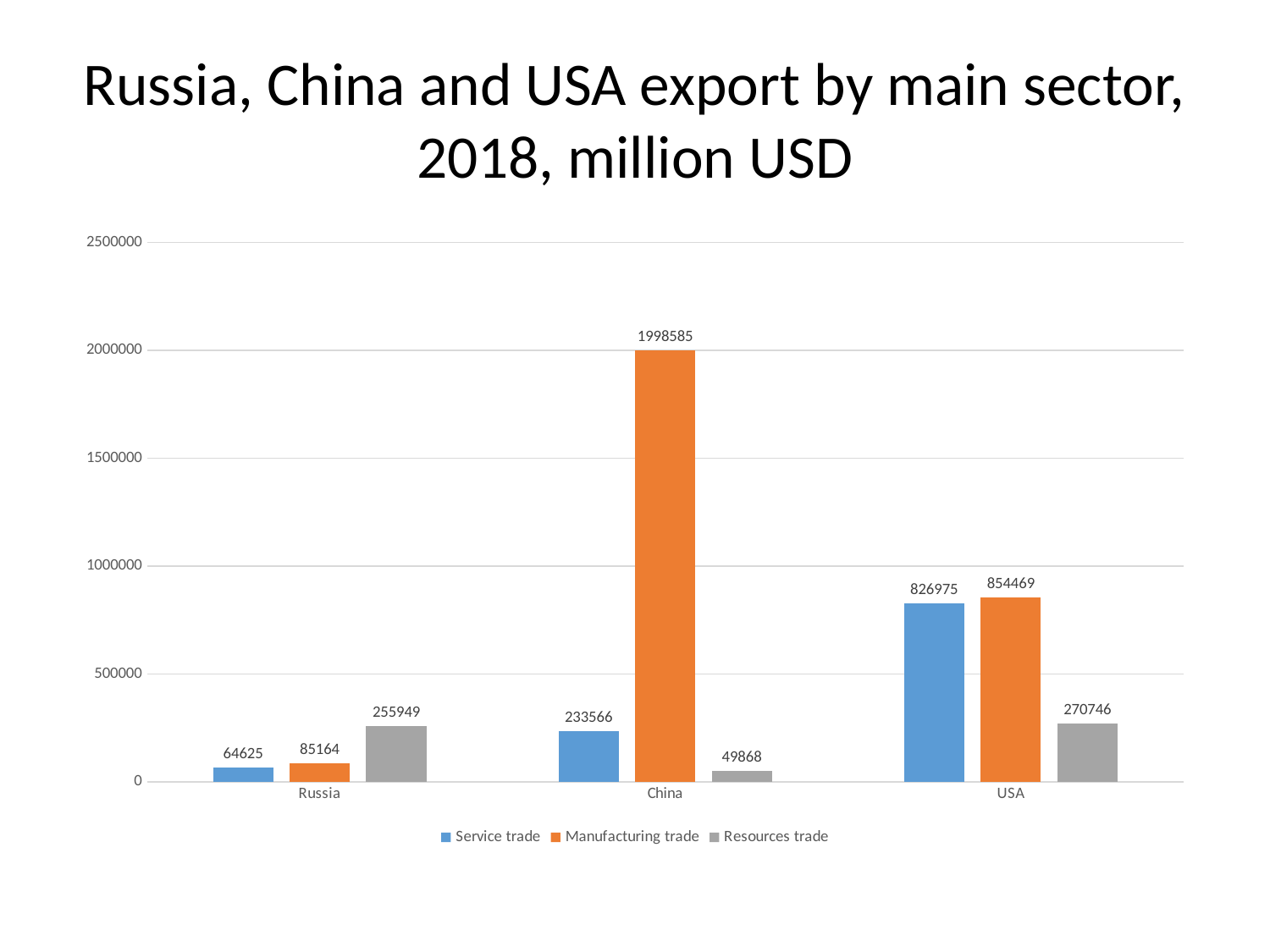
What is the difference between the Manufacturing trade and Service trade values for USA? 27494 What is the Manufacturing trade value for China? 1998585 Which country has the lowest Resources trade value? China What colour represents Resources trade in the chart? grey What is the Service trade value for Russia? 64625 How many series does the legend list? 3 Which is larger for Russia: Resources trade or Manufacturing trade? Resources trade What is the Resources trade value for USA? 270746 Which country has the highest Manufacturing trade value? China How many countries are shown on the x axis? 3 What kind of chart is shown on the slide? bar chart Is the Service trade value for USA greater or less than 1000000? less